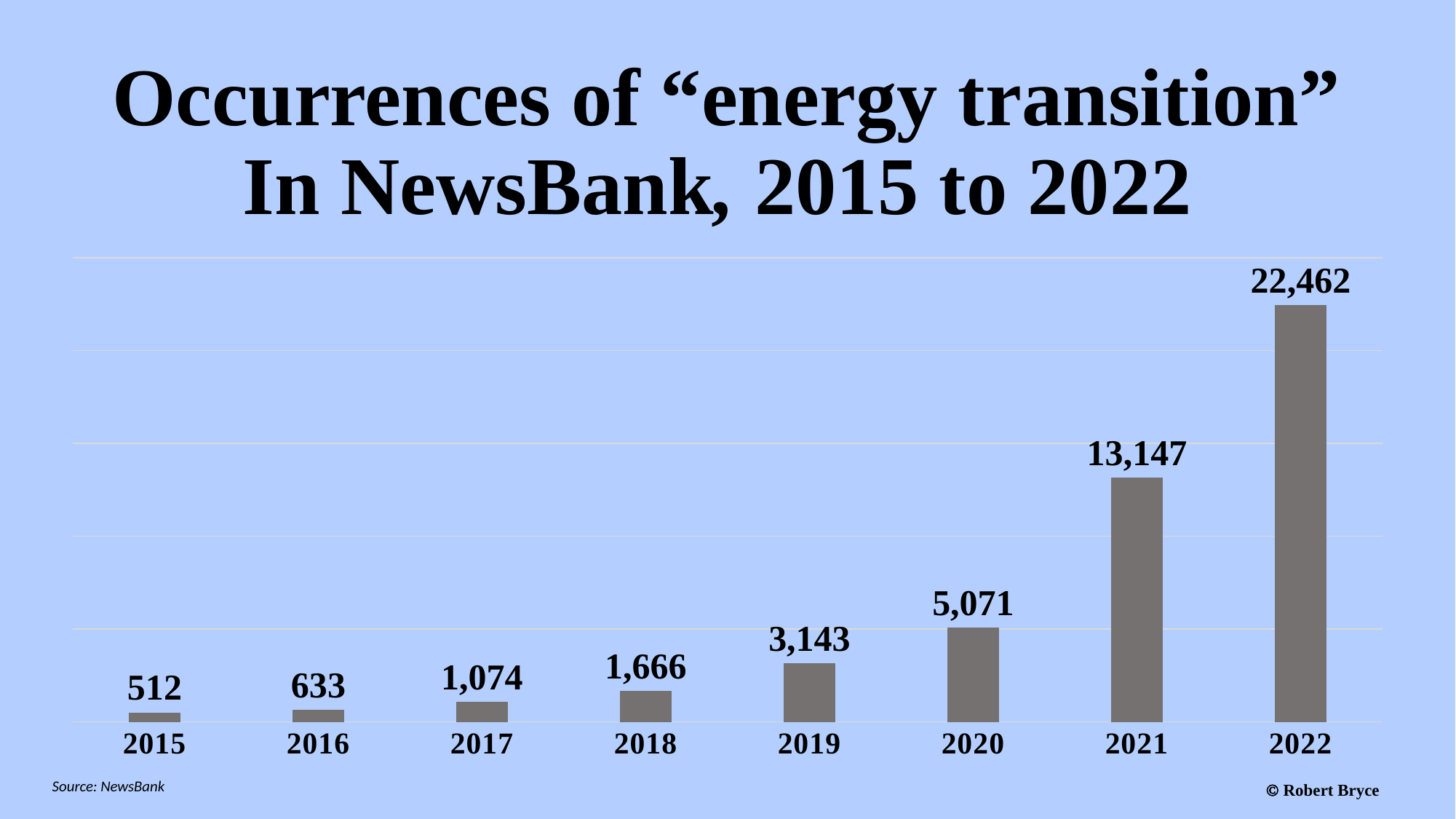
Which year has a larger value, 2018 or 2020? 2020 What is the value shown for 2019? 3,143 Which year has the highest number of occurrences? 2022 What is the difference between the values for 2022 and 2021? 9,315 What is the number of occurrences of "energy transition" in 2022? 22,462 What is the difference between the values for 2016 and 2015? 121 What is the number of occurrences of "energy transition" in 2015? 512 Which year has the lowest number of occurrences? 2015 What is the value shown for 2021? 13,147 How many years are shown on the x axis? 8 Do the values rise or fall from 2015 to 2022? Rise What kind of chart is shown on the slide? Bar chart